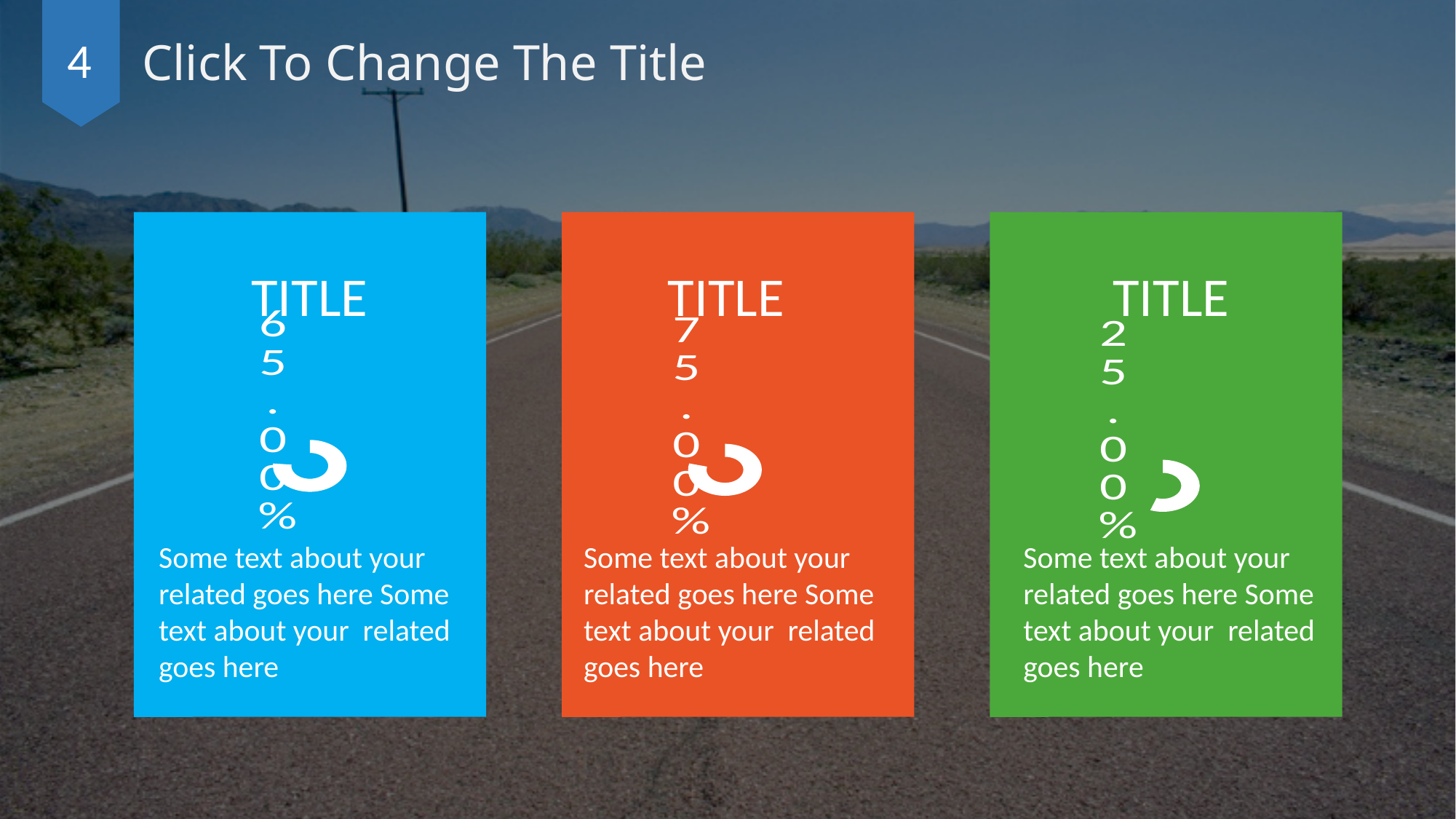
How many charts are shown on the slide? 3 Is the value on the right (green) panel's chart greater or less than 50%? less What value is shown on the middle (orange) panel's chart? 75.00% What is the difference between the middle (orange) panel's value and the left (blue) panel's value? 10.00% Which is larger, the value on the left (blue) panel's chart or the value on the right (green) panel's chart? The left (blue) panel's chart Which panel's chart shows the lowest percentage? The right (green) panel Which panel's chart shows the highest percentage? The middle (orange) panel What kind of chart is used in each panel? Doughnut chart What value is shown on the left (blue) panel's chart? 65.00% What is the difference between the middle (orange) panel's value and the right (green) panel's value? 50.00% What value is shown on the right (green) panel's chart? 25.00% What colour is the background of the panel containing the 75.00% chart? Orange